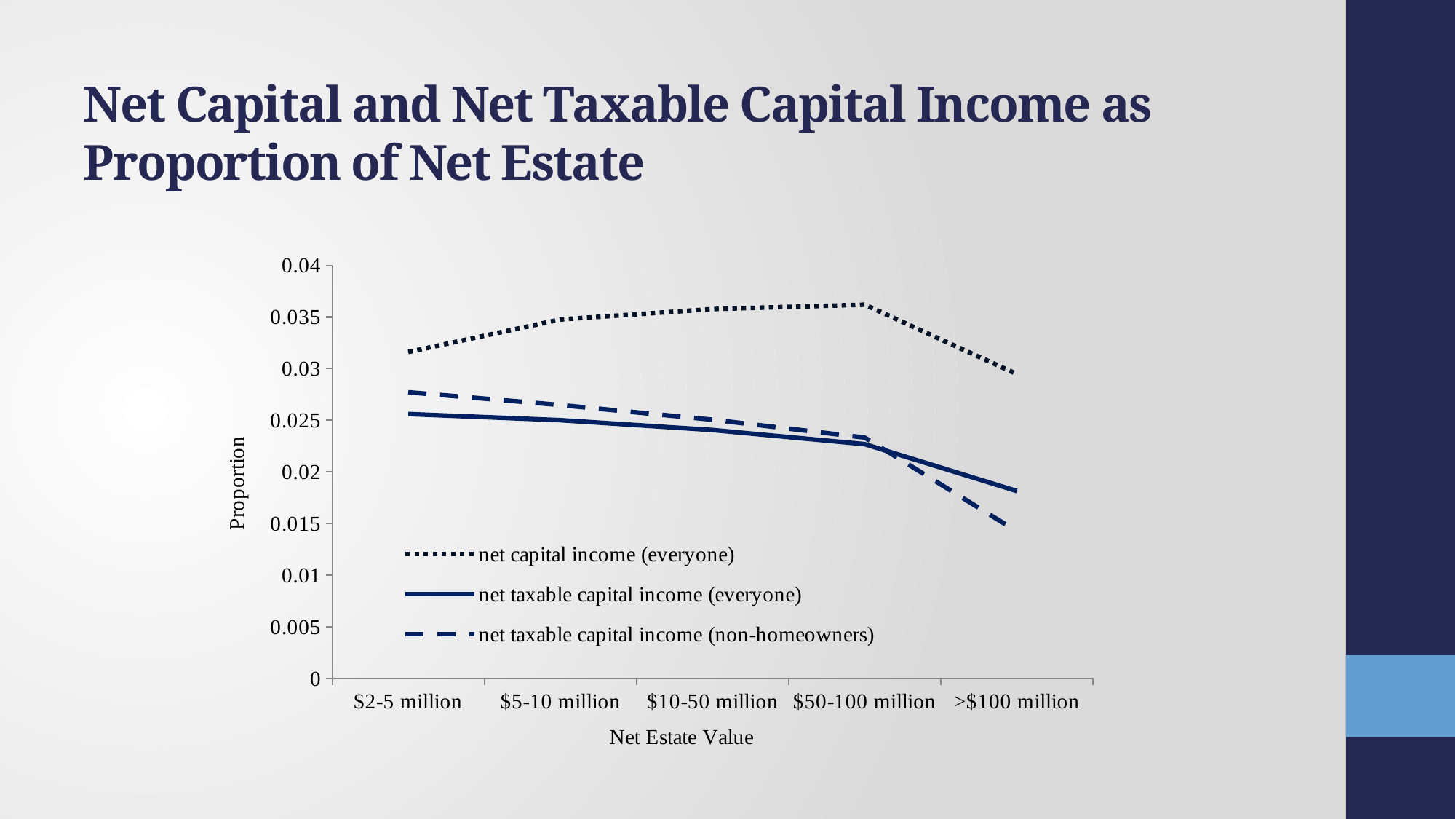
How many net estate value categories are shown on the x axis? 5 Does net taxable capital income (everyone) rise or fall as net estate value increases along the x axis? fall For which net estate value category is net taxable capital income (everyone) lowest? >$100 million For which net estate value category is net capital income (everyone) lowest? >$100 million At $2-5 million, which is higher: net taxable capital income (everyone) or net taxable capital income (non-homeowners)? net taxable capital income (non-homeowners) What is the label of the x axis? Net Estate Value Is the value for net capital income (everyone) at $2-5 million greater or less than 0.03? greater Is the value for net taxable capital income (non-homeowners) at >$100 million greater or less than 0.02? less How many series does the legend list? 3 What kind of chart is shown on the slide? line chart At >$100 million, which is higher: net taxable capital income (everyone) or net taxable capital income (non-homeowners)? net taxable capital income (everyone) Is the value for net capital income (everyone) at >$100 million greater or less than 0.025? greater